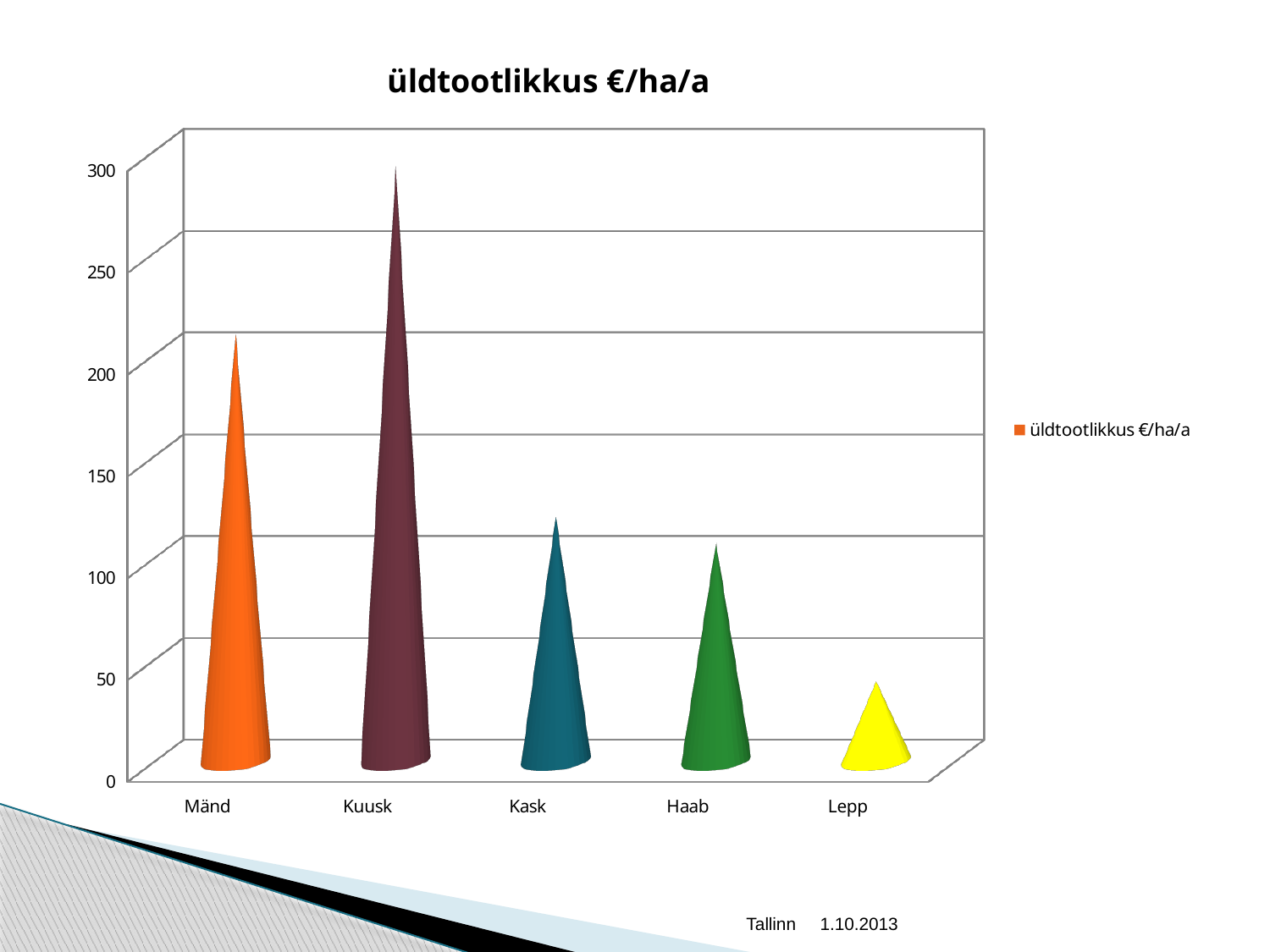
Is the value for Kuusk greater or less than 250? greater What is the title of the chart? üldtootlikkus €/ha/a Which is larger, the value for Mänd or the value for Kask? Mänd Which category has the highest value? Kuusk How many series does the legend list? 1 Which is larger, the value for Haab or the value for Lepp? Haab What kind of chart is shown on the slide? bar chart Is the value for Kask greater or less than 150? less How many categories are shown on the x axis of the chart? 5 Is the value for Lepp greater or less than 100? less Which category has the lowest value? Lepp